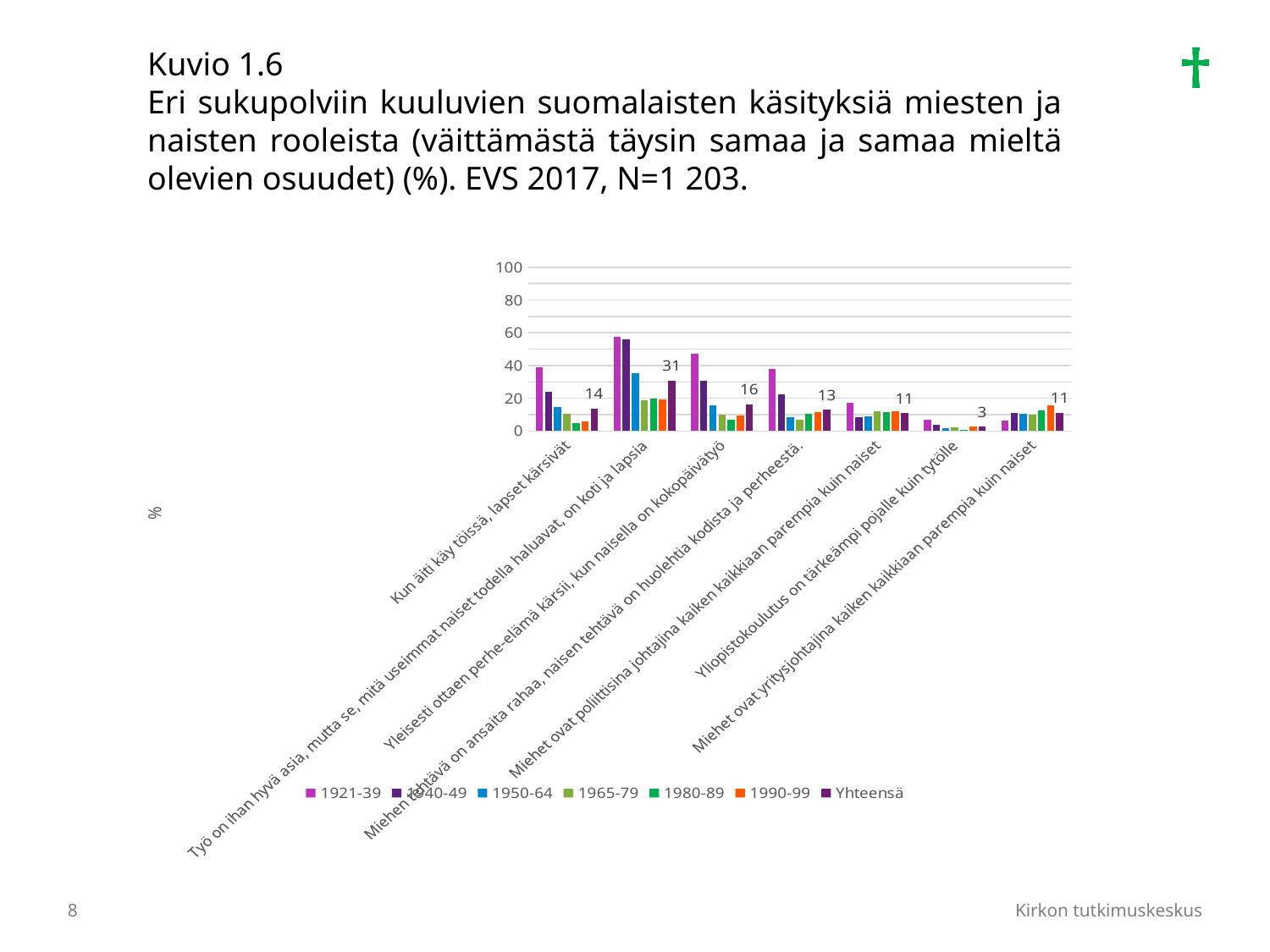
What is the Yhteensä value for "Miehen tehtävä on ansaita rahaa, naisen tehtävä on huolehtia kodista ja perheestä"? 13 Which statement has the lowest Yhteensä value? Yliopistokoulutus on tärkeämpi pojalle kuin tytölle What is the Yhteensä value for "Yliopistokoulutus on tärkeämpi pojalle kuin tytölle"? 3 Which statement has the highest Yhteensä value? Työ on ihan hyvä asia, mutta se, mitä useimmat naiset todella haluavat, on koti ja lapsia Is the 1921-39 value for "Yliopistokoulutus on tärkeämpi pojalle kuin tytölle" greater or less than 20? less What is the Yhteensä value for "Kun äiti käy töissä, lapset kärsivät"? 14 Which has the larger Yhteensä value: "Yleisesti ottaen perhe-elämä kärsii, kun naisella on kokopäivätyö" or "Kun äiti käy töissä, lapset kärsivät"? Yleisesti ottaen perhe-elämä kärsii, kun naisella on kokopäivätyö What is the Yhteensä value for "Työ on ihan hyvä asia, mutta se, mitä useimmat naiset todella haluavat, on koti ja lapsia"? 31 What kind of chart is shown on the slide? bar chart Is the 1921-39 value for "Työ on ihan hyvä asia, mutta se, mitä useimmat naiset todella haluavat, on koti ja lapsia" greater or less than 40? greater What is the difference between the Yhteensä values for "Työ on ihan hyvä asia..." (31) and "Yliopistokoulutus on tärkeämpi pojalle kuin tytölle" (3)? 28 How many series does the legend list? 7